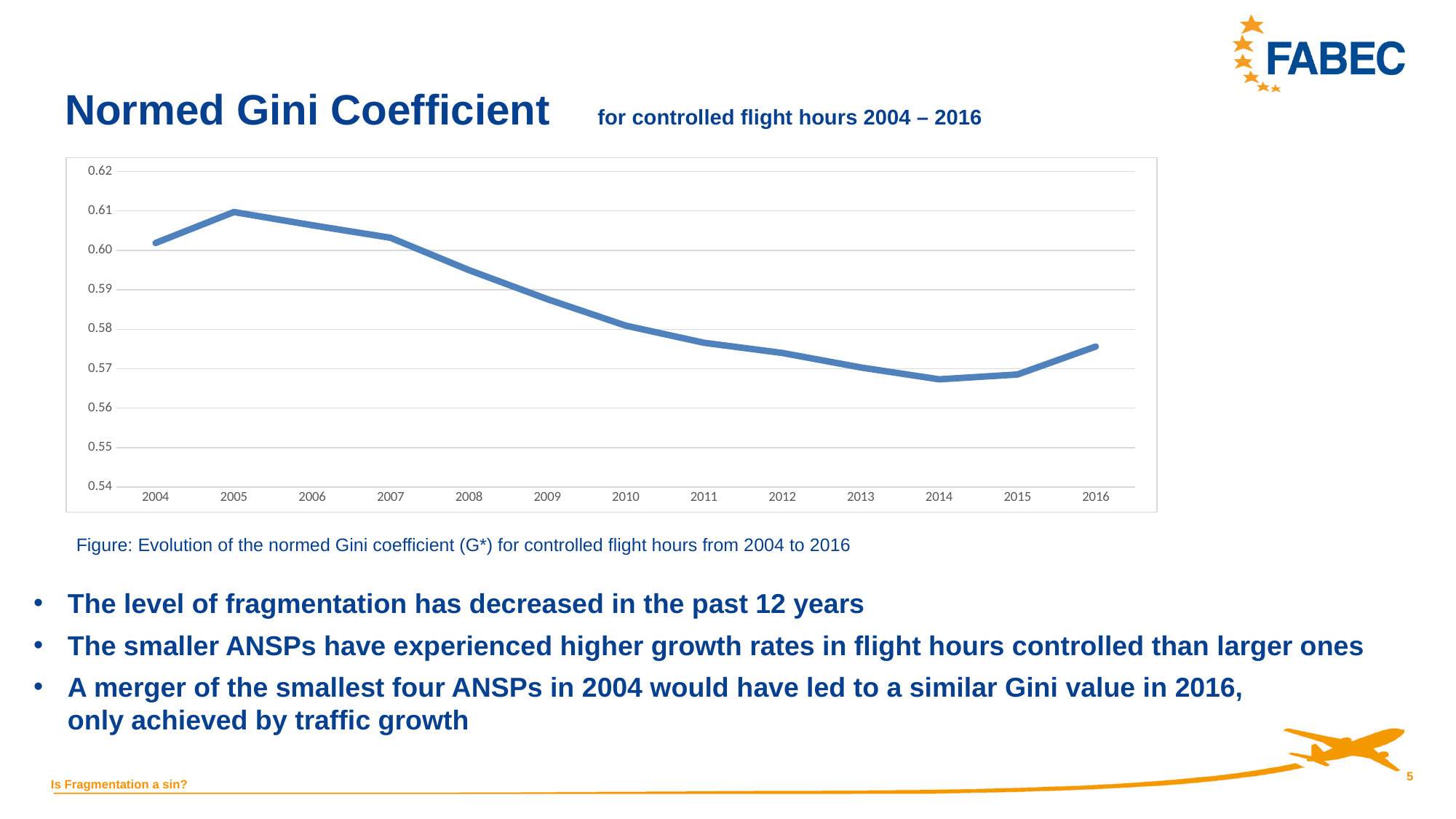
Is the value for 2016 greater or less than 0.57? greater Is the value for 2004 greater or less than 0.60? greater Which year has the larger normed Gini coefficient, 2010 or 2012? 2010 In which year does the normed Gini coefficient reach its highest value? 2005 Is the value for 2008 greater or less than 0.60? less What kind of chart is shown on the slide? line chart Which year has the larger normed Gini coefficient, 2004 or 2016? 2004 How many years are plotted on the x axis of the chart? 13 What is the first year shown on the x axis of the chart? 2004 Does the normed Gini coefficient generally rise or fall between 2005 and 2014? fall